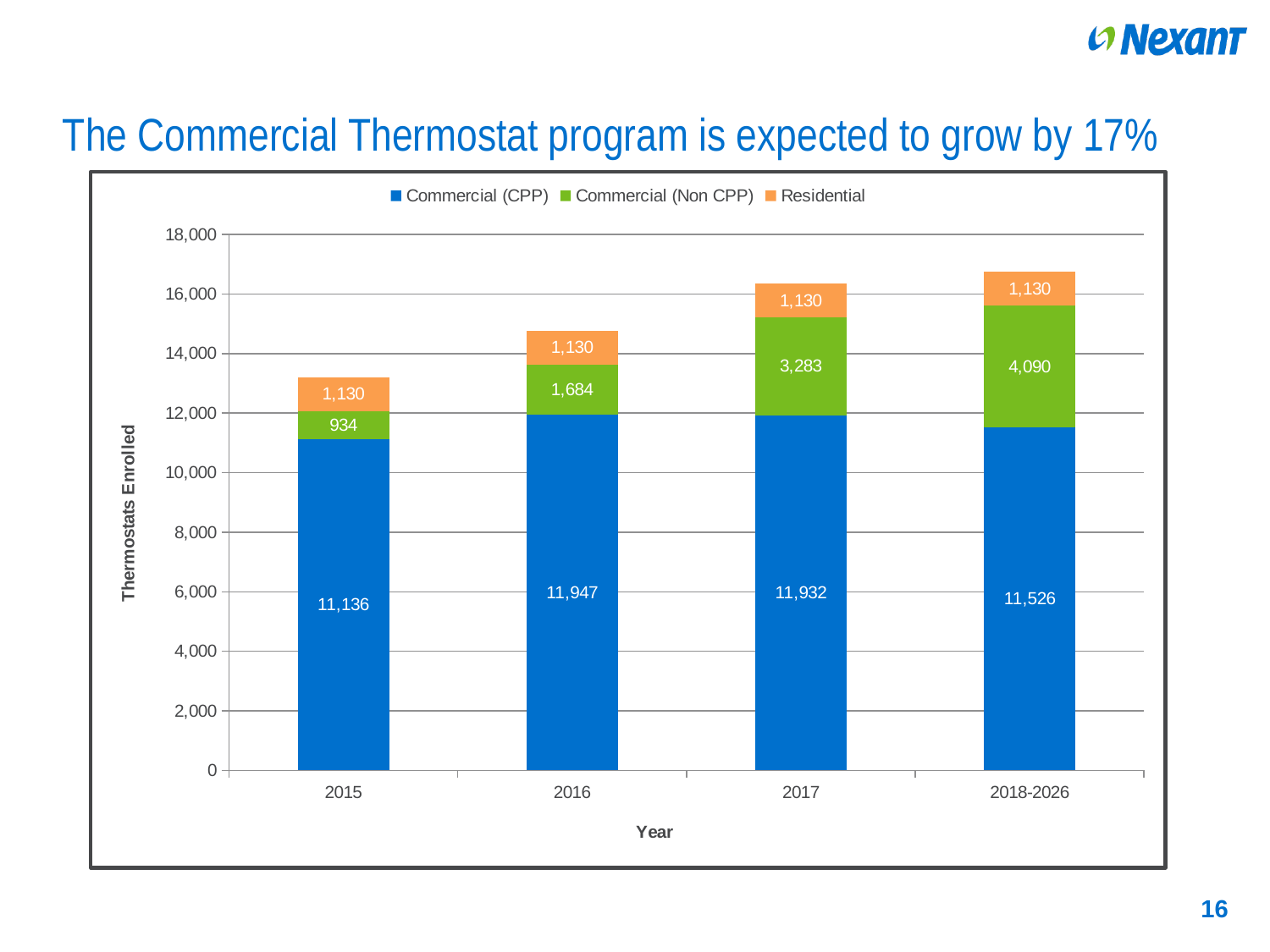
How many year categories are shown on the x axis? 4 What kind of chart is shown on the slide? Stacked bar chart Which is larger, the Commercial (CPP) value for 2016 or for 2018-2026? 2016 Which year has the highest Commercial (Non CPP) value? 2018-2026 What is the total of the stacked bar for 2018-2026? 16,746 What is the Residential value for 2018-2026? 1,130 What is the Commercial (CPP) value for 2015? 11,136 How many series does the legend list? 3 What is the difference between the Commercial (Non CPP) values for 2018-2026 and 2015? 3,156 What is the Commercial (Non CPP) value for 2017? 3,283 What is the total of the stacked bar for 2015? 13,200 Which year has the lowest Commercial (CPP) value? 2015